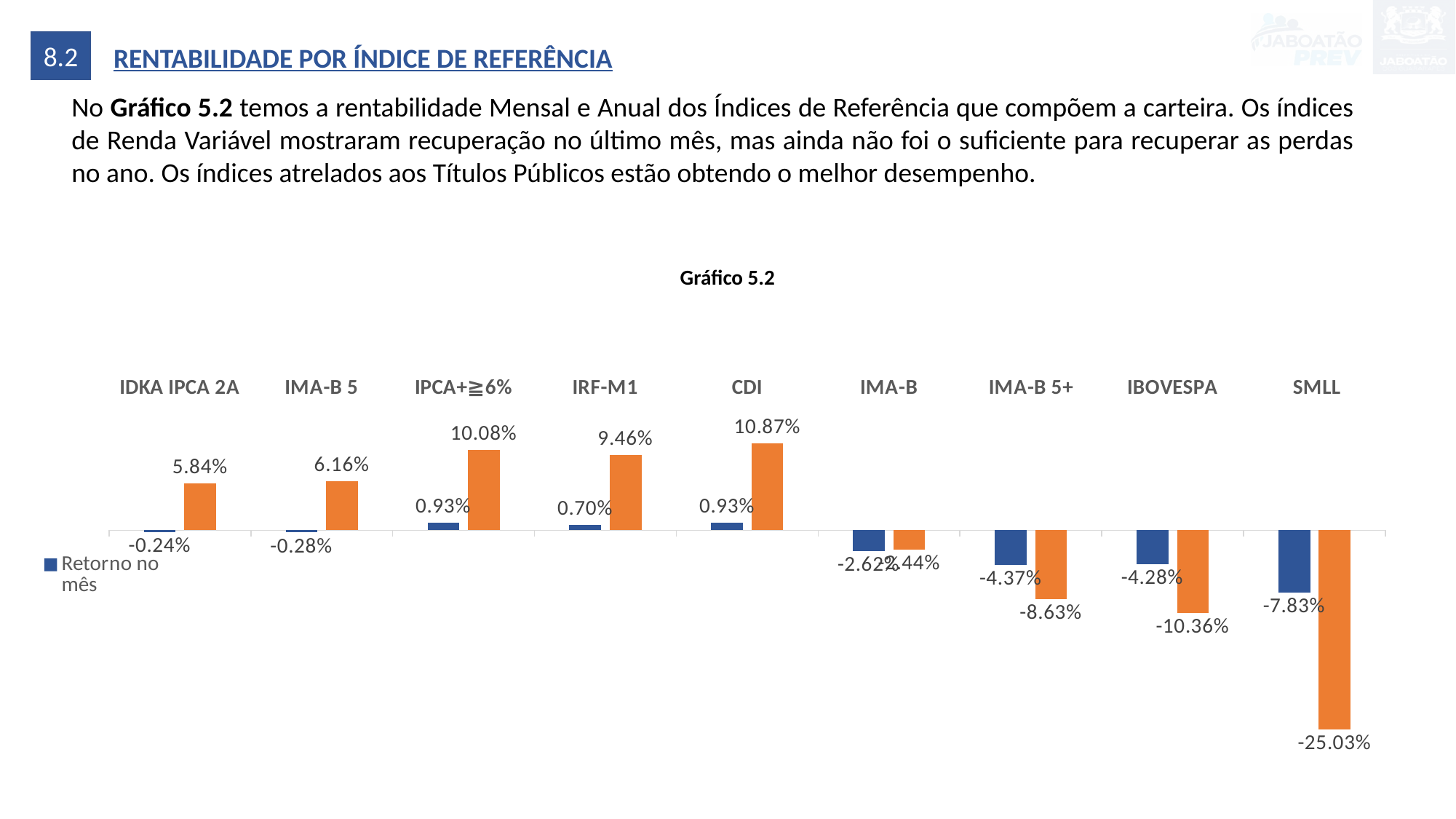
What is the difference between the orange-bar values for CDI and IPCA+≧6%? 0.79% What is the value of the orange bar for IBOVESPA? -10.36% How many reference indices (categories) are shown in Gráfico 5.2? 9 Which index has the lowest orange-bar value? SMLL What is the 'Retorno no mês' value for CDI? 0.93% What is the value of the orange bar for IRF-M1? 9.46% What is the 'Retorno no mês' value for SMLL? -7.83% What series name is shown in the legend of Gráfico 5.2? Retorno no mês What type of chart is Gráfico 5.2? bar chart Which index has the lowest 'Retorno no mês' value? SMLL Which is larger, the orange-bar value for IMA-B 5 or for IDKA IPCA 2A? IMA-B 5 Which index has the highest orange-bar value? CDI